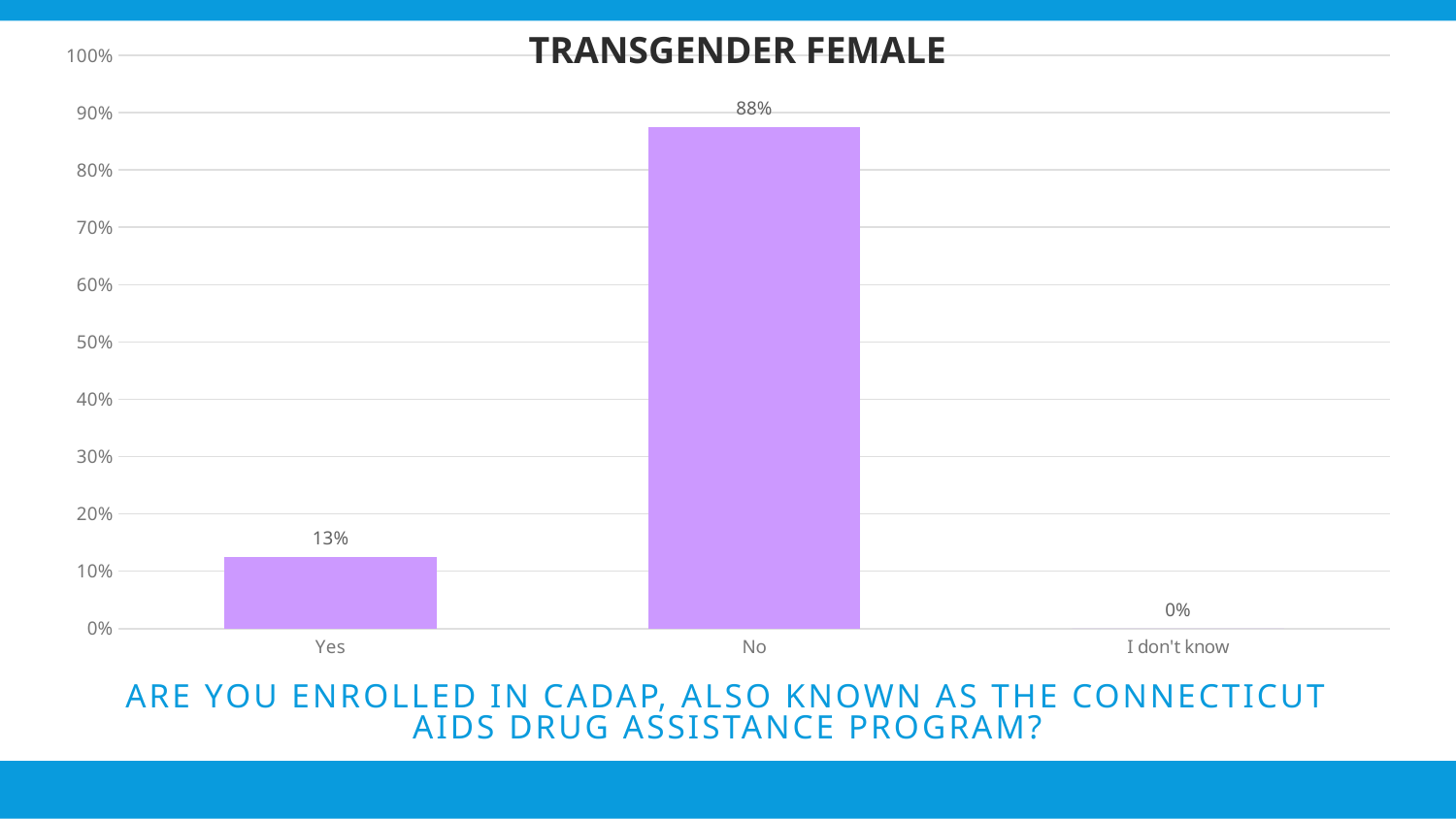
Which response category has the highest value? No What is the difference between the "No" and "Yes" percentages? 75% How many response categories are shown on the x axis? 3 What type of chart is shown on the slide? Bar chart What is the title of the chart? TRANSGENDER FEMALE Which is larger, the value for "Yes" or the value for "No"? No Is the value for "No" greater or less than 80%? greater What percentage of respondents answered "No"? 88% Which response category has the lowest value? I don't know What percentage of respondents answered "I don't know"? 0% What percentage of respondents answered "Yes"? 13% Is the value for "Yes" greater or less than 20%? less